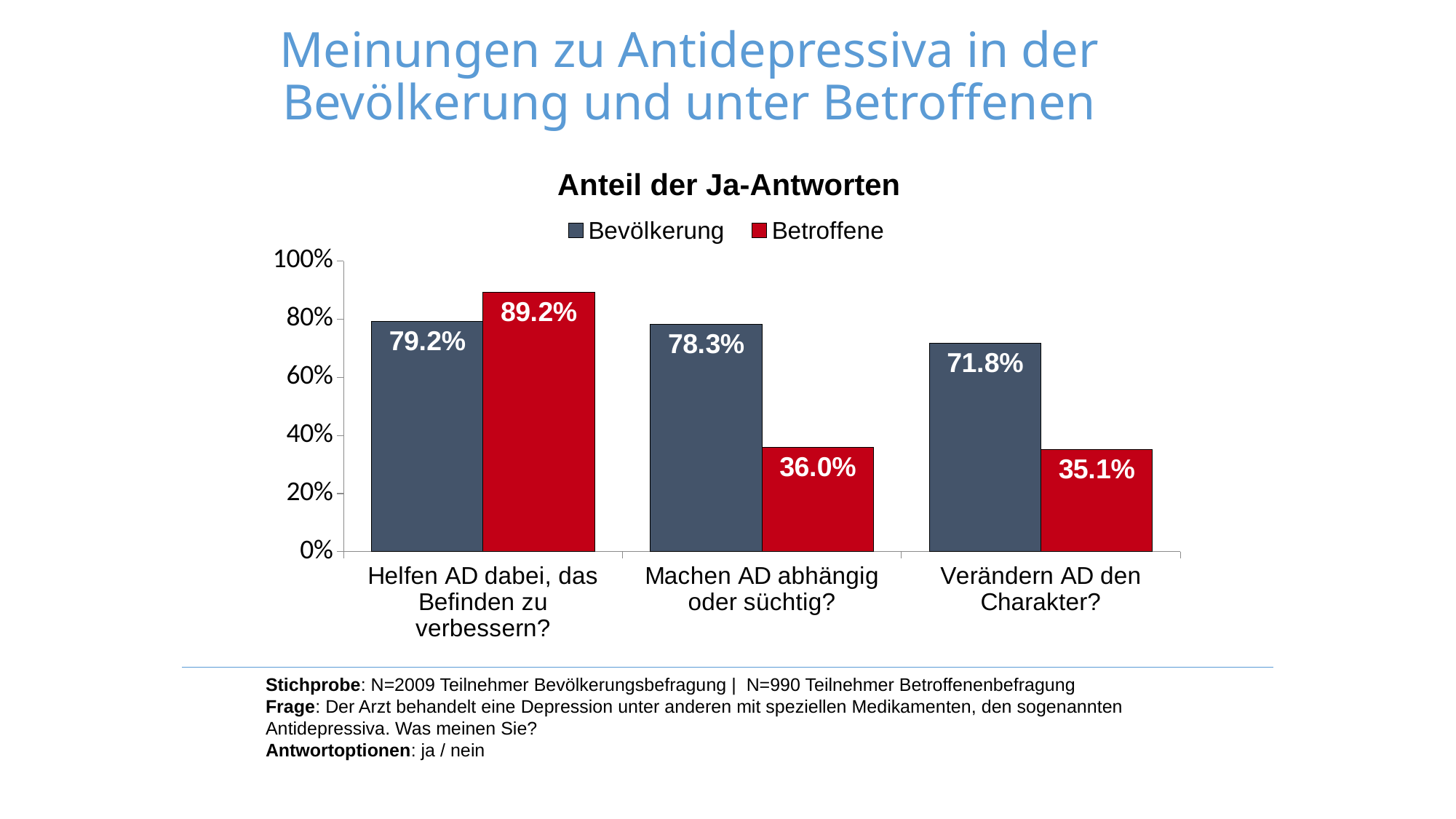
What is the Bevölkerung value for "Helfen AD dabei, das Befinden zu verbessern?"? 79.2% Is the Betroffene value for "Helfen AD dabei, das Befinden zu verbessern?" greater or less than 80%? greater How many categories are shown on the x axis? 3 What is the Betroffene value for "Machen AD abhängig oder süchtig?"? 36.0% For "Verändern AD den Charakter?", which is larger: the Bevölkerung value or the Betroffene value? Bevölkerung How many series does the legend list? 2 What kind of chart is shown on the slide? bar chart Which category has the lowest Bevölkerung value? Verändern AD den Charakter? What is the difference between the Bevölkerung and Betroffene values for "Machen AD abhängig oder süchtig?"? 42.3% What is the difference between the Betroffene and Bevölkerung values for "Helfen AD dabei, das Befinden zu verbessern?"? 10.0% Which category has the highest Betroffene value? Helfen AD dabei, das Befinden zu verbessern? What is the Betroffene value for "Verändern AD den Charakter?"? 35.1%